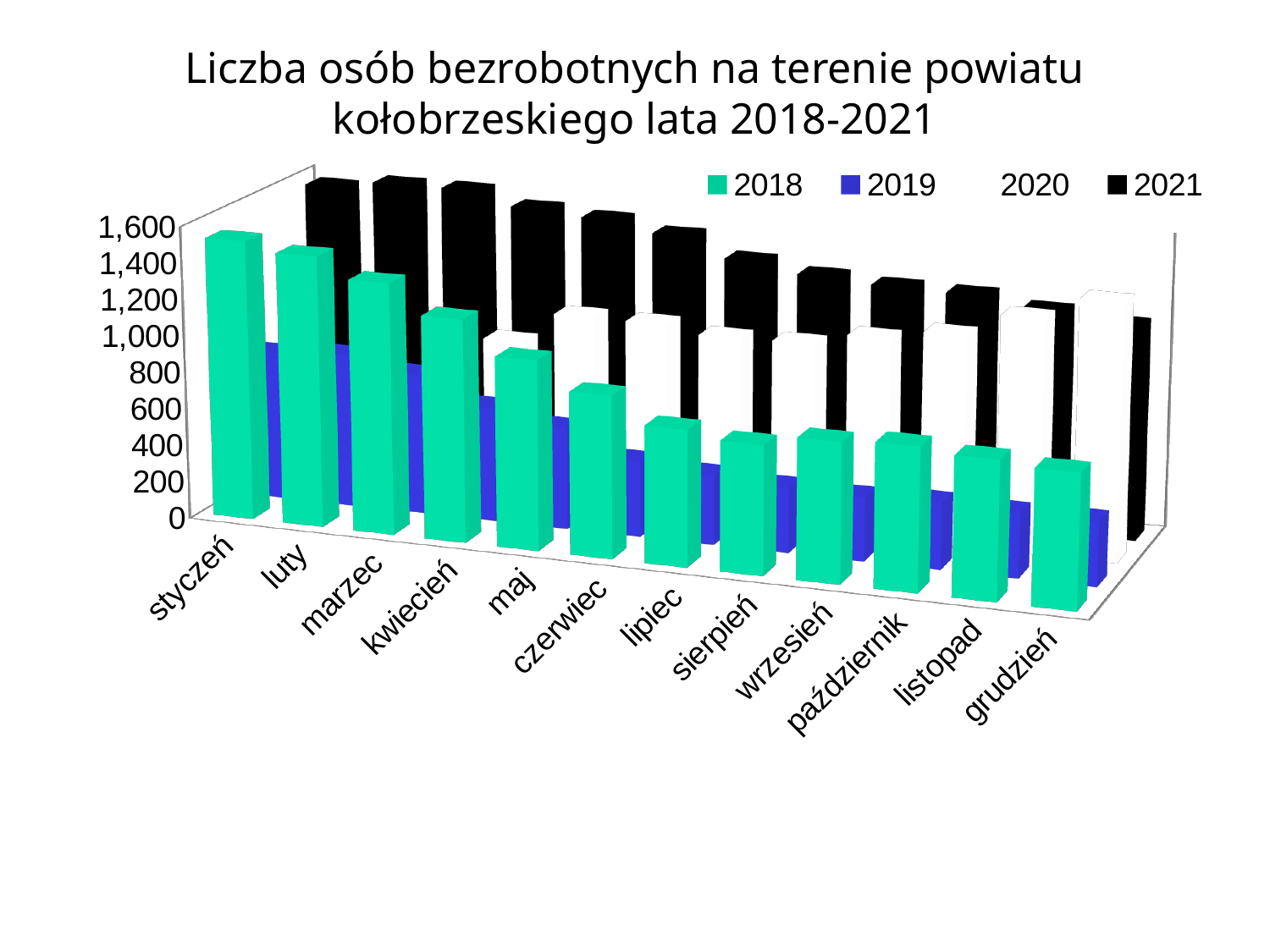
Is the 2018 value for grudzień greater or less than 800? less What kind of chart is shown on the slide? bar chart Which is larger for 2018: the value for styczeń or the value for grudzień? styczeń How many months (categories) are shown on the x axis? 12 Is the 2018 value for czerwiec greater or less than 1,000? less Which years are listed in the legend? 2018, 2019, 2020, 2021 For the 2018 series, which month has the highest value? styczeń How many series does the legend list? 4 What is the title of the chart? Liczba osób bezrobotnych na terenie powiatu kołobrzeskiego lata 2018-2021 Is the 2018 value for styczeń greater or less than 1,000? greater For the 2018 series, do the values rise or fall from styczeń to grudzień? fall Which is larger for 2018: the value for luty or the value for sierpień? luty